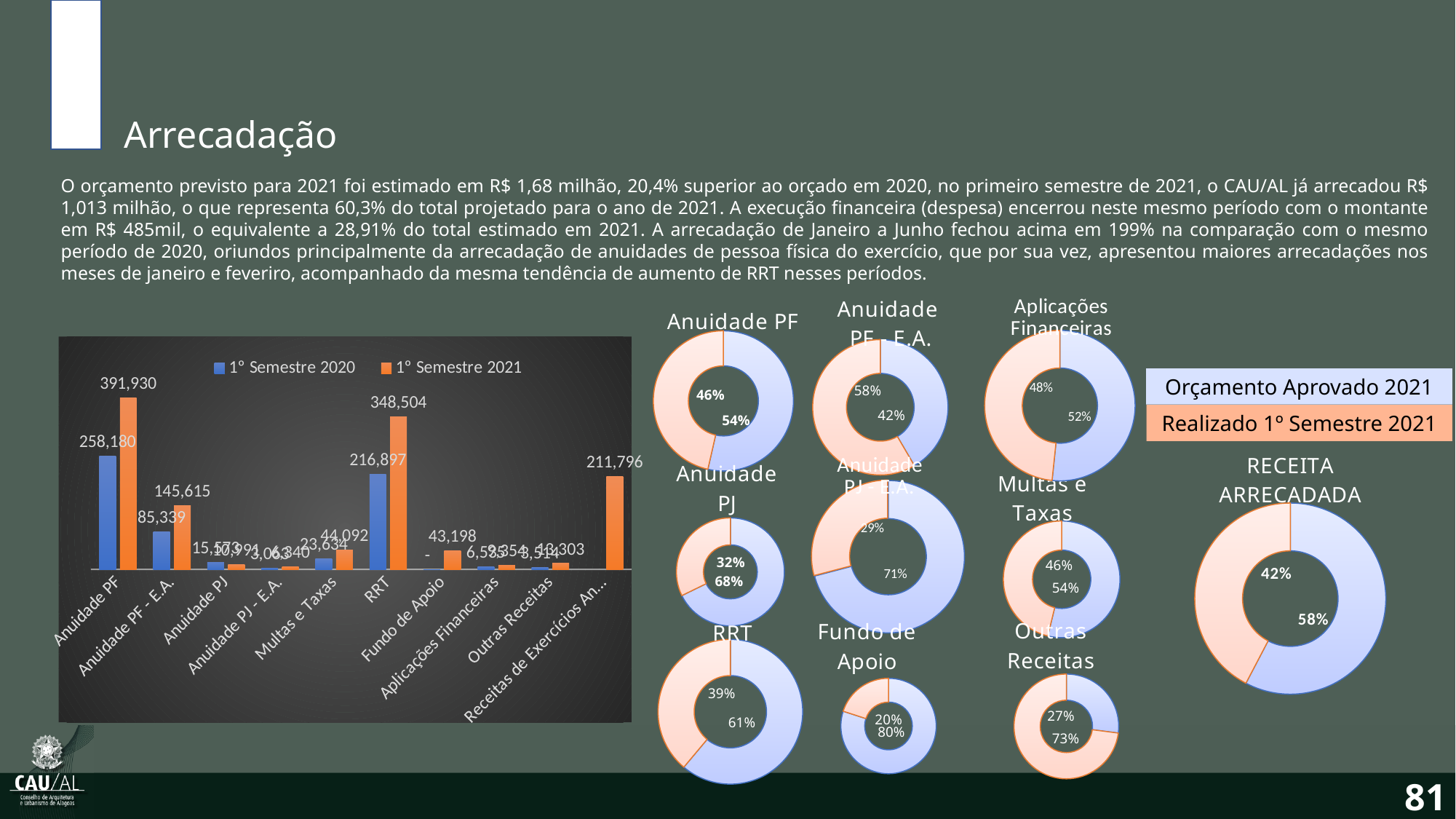
In the bar chart, what is the value for Anuidade PF - E.A. in 1º Semestre 2021? 145,615 How many categories are shown on the x axis of the bar chart? 10 In the bar chart, what is the difference between the 1º Semestre 2021 and 1° Semestre 2020 values for RRT? 131,607 In the bar chart, what is the difference between the 1º Semestre 2021 and 1° Semestre 2020 values for Anuidade PF? 133,750 In the bar chart, which is larger for Anuidade PF - E.A.: the 1° Semestre 2020 value or the 1º Semestre 2021 value? 1º Semestre 2021 In the bar chart, what is the value for RRT in 1° Semestre 2020? 216,897 On the RRT donut chart, what is the larger of the two percentages shown? 61% In the bar chart, what is the value for Receitas de Exercícios Anteriores in 1º Semestre 2021? 211,796 How many series does the legend of the bar chart list? 2 What kind of chart is the chart on the left of the slide? Bar chart In the bar chart, what is the value for Anuidade PF in 1º Semestre 2021? 391,930 In the bar chart, which category has the highest value for 1º Semestre 2021? Anuidade PF